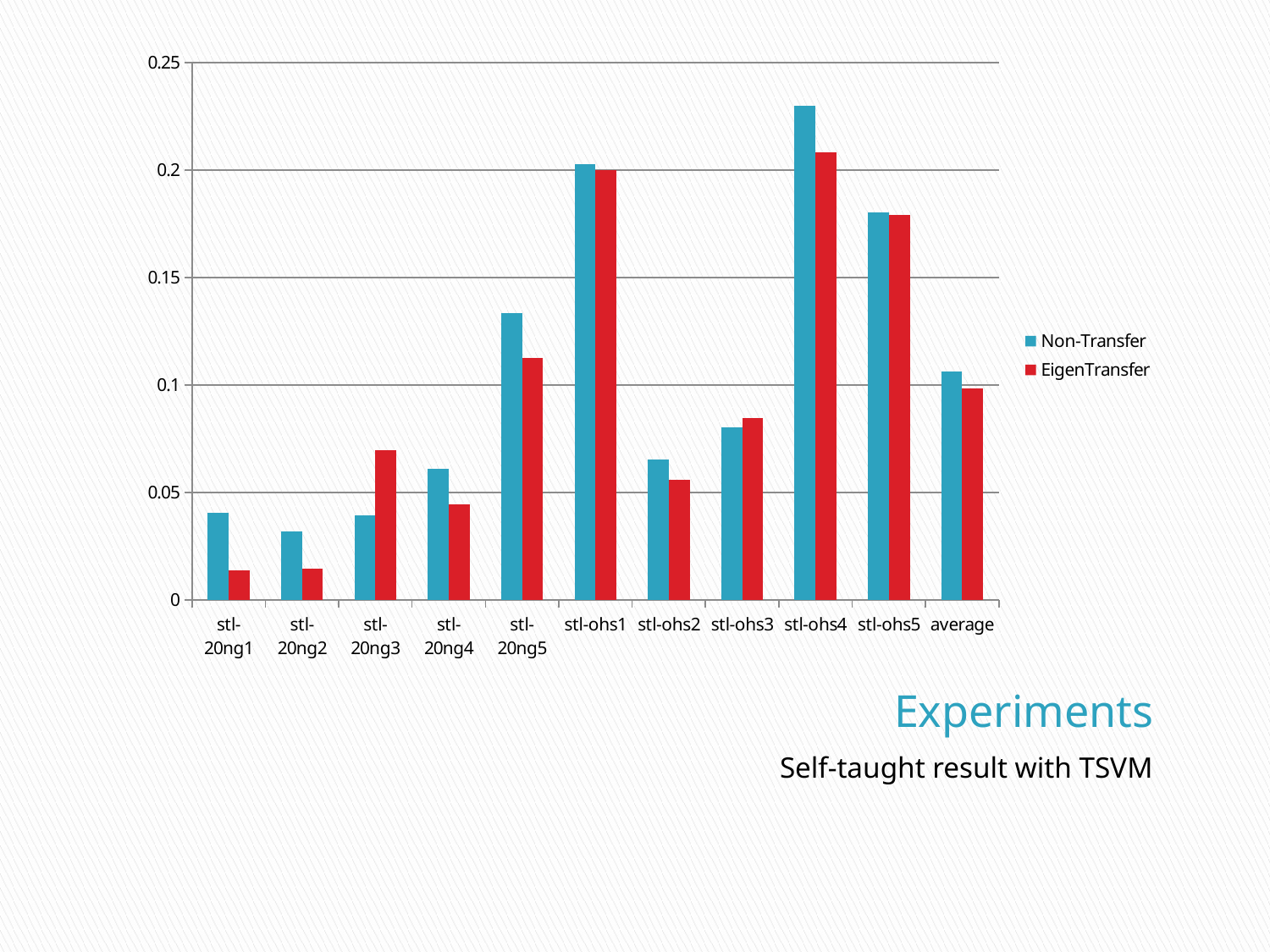
Which category has the highest EigenTransfer value? stl-ohs4 For stl-20ng1, which series has the larger value, Non-Transfer or EigenTransfer? Non-Transfer Is the EigenTransfer value for stl-20ng3 greater or less than 0.05? greater Is the Non-Transfer value for stl-20ng5 greater or less than 0.1? greater Is the Non-Transfer value for stl-ohs4 greater or less than 0.2? greater Which category has the lowest Non-Transfer value? stl-20ng2 For stl-20ng3, which series has the larger value, Non-Transfer or EigenTransfer? EigenTransfer How many categories are shown on the x axis? 11 What kind of chart is shown on the slide? bar chart How many series does the legend list? 2 Which category has the highest Non-Transfer value? stl-ohs4